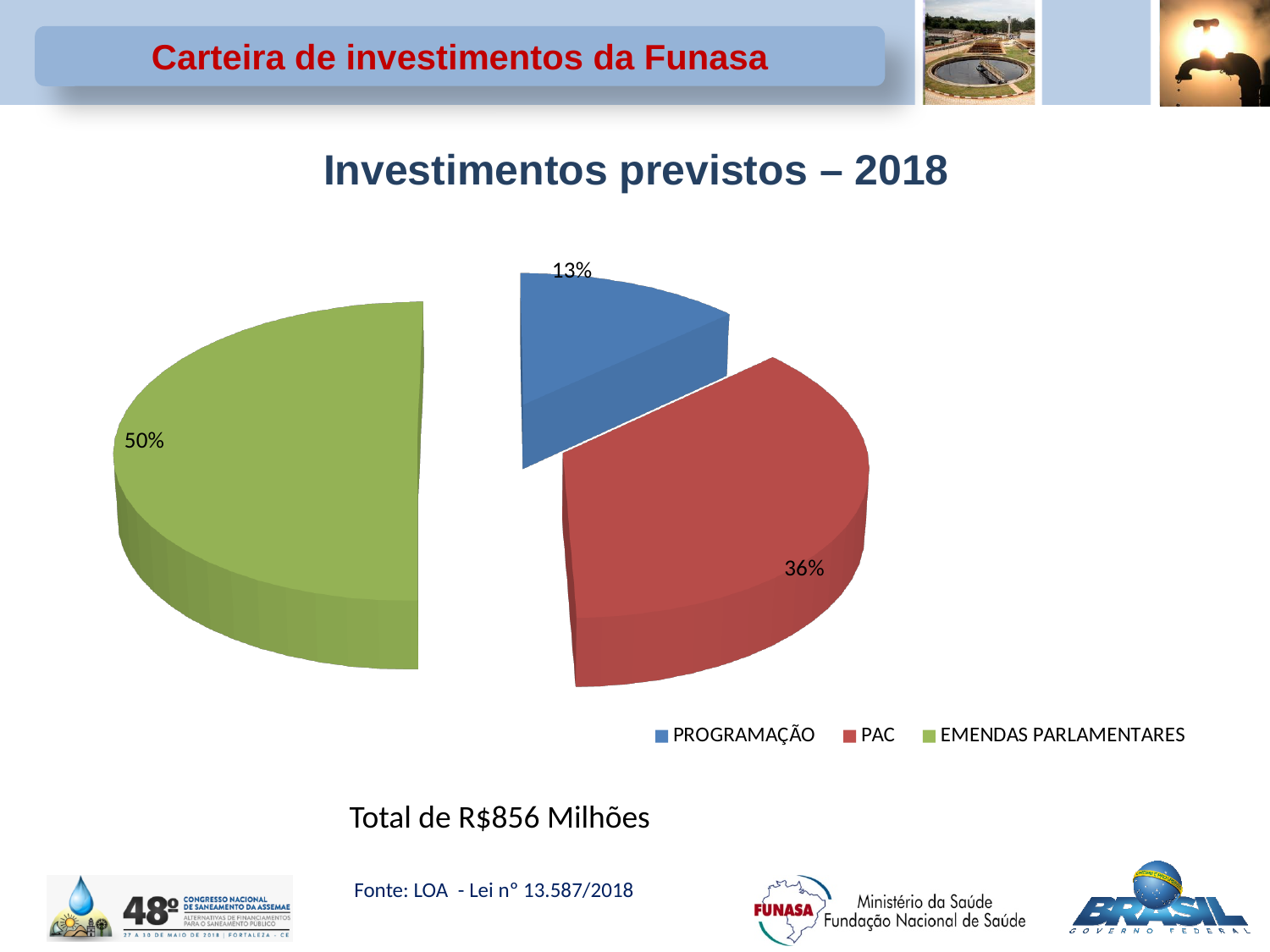
Which category has the largest share of the pie? EMENDAS PARLAMENTARES How many slices does the pie chart have? 3 What is the difference in percentage points between the PAC share and the PROGRAMAÇÃO share? 23 What is the title of the chart? Investimentos previstos – 2018 What share of the pie does PAC represent? 36% What share of the pie does PROGRAMAÇÃO represent? 13% How many entries does the legend list? 3 Which has a larger share, PAC or EMENDAS PARLAMENTARES? EMENDAS PARLAMENTARES What share of the pie does EMENDAS PARLAMENTARES represent? 50% What colour is the PAC slice? Red Which category has the smallest share of the pie? PROGRAMAÇÃO What kind of chart is shown on the slide? Pie chart